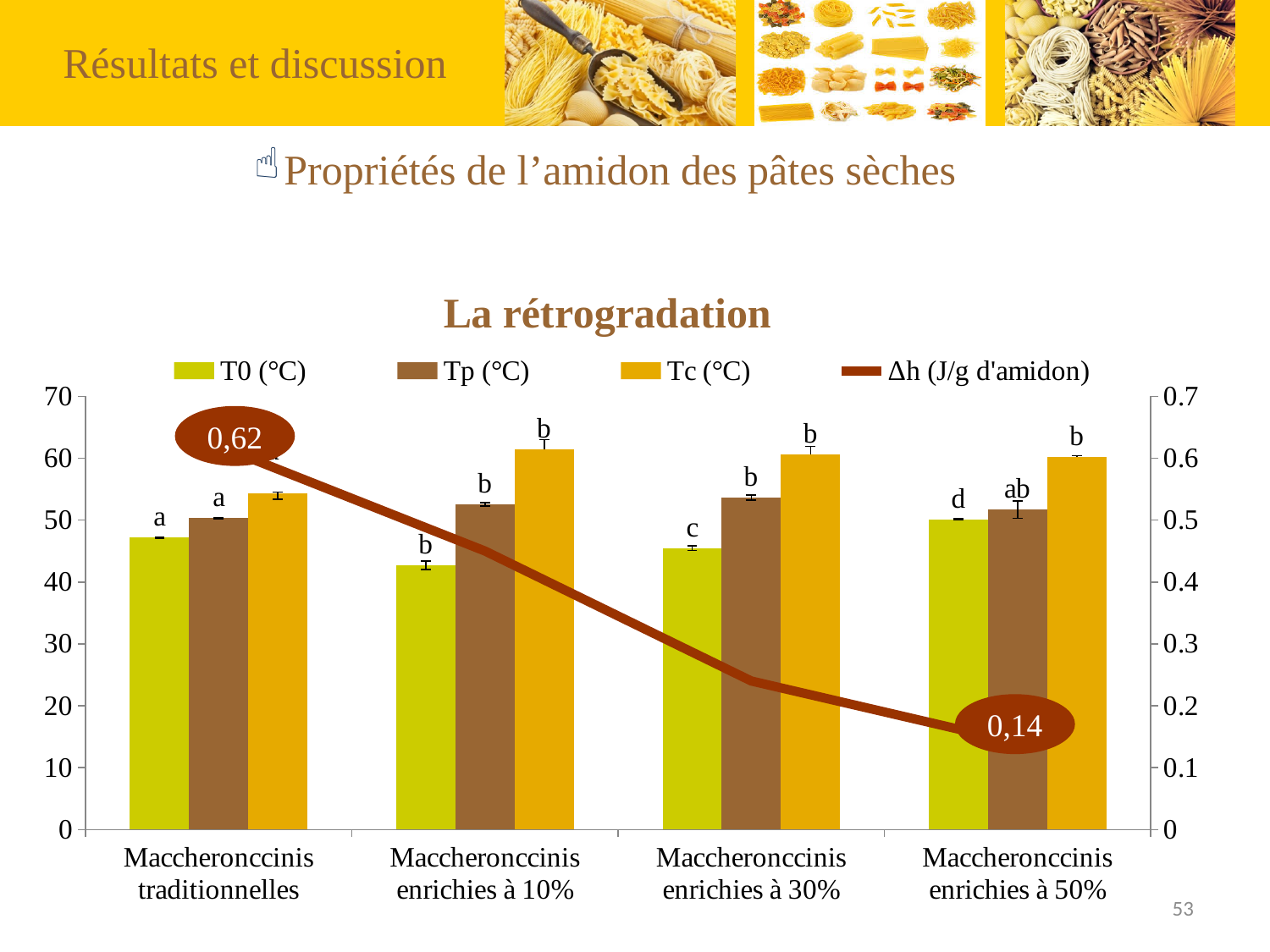
Is the Tp (°C) value for Maccheronccinis enrichies à 30% greater or less than 50? greater What is the Δh (J/g d'amidon) value for Maccheronccinis traditionnelles? 0,62 Is the T0 (°C) value for Maccheronccinis enrichies à 10% greater or less than 50? less Does the Δh (J/g d'amidon) line rise or fall from Maccheronccinis traditionnelles to Maccheronccinis enrichies à 50%? fall Which category has the lowest Tc (°C) value? Maccheronccinis traditionnelles Which category has the lowest T0 (°C) value? Maccheronccinis enrichies à 10% What is the difference between the Δh values for Maccheronccinis traditionnelles and Maccheronccinis enrichies à 50%? 0,48 What is the title of the chart? La rétrogradation How many categories are shown on the x axis? 4 What is the Δh (J/g d'amidon) value for Maccheronccinis enrichies à 50%? 0,14 Which is larger, the T0 (°C) value for Maccheronccinis traditionnelles or for Maccheronccinis enrichies à 10%? Maccheronccinis traditionnelles How many series does the legend list? 4